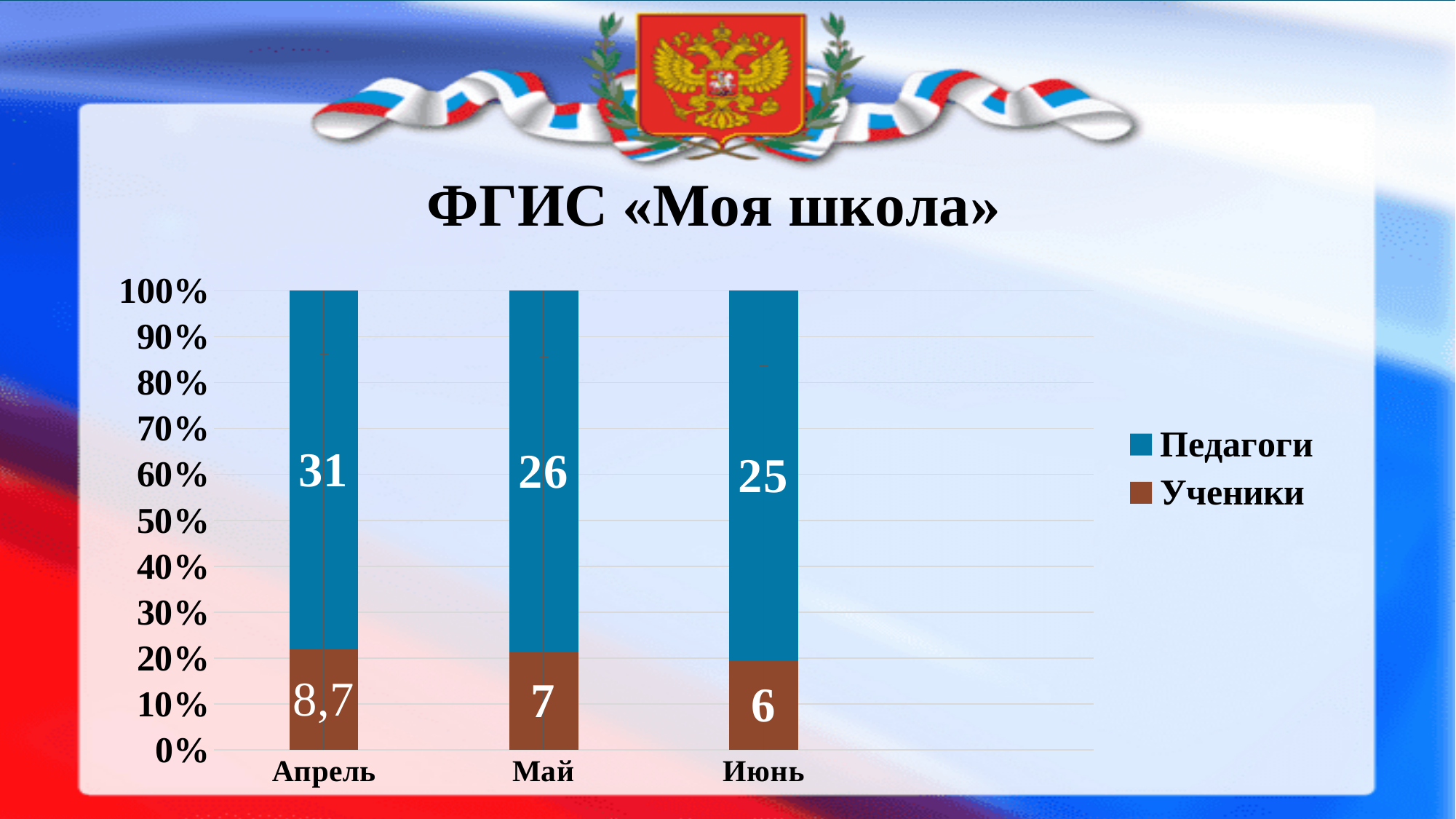
In which month is the Педагоги value highest? Апрель How many series does the legend list? 2 What is the value for Ученики in Апрель? 8,7 Which is larger, the Педагоги value for Май or for Июнь? Май What is the value for Педагоги in Апрель? 31 In which month is the Ученики value lowest? Июнь Do the Педагоги values rise or fall from Апрель to Июнь? Fall What kind of chart is shown on the slide? Stacked bar chart What is the value for Ученики in Май? 7 What is the value for Педагоги in Июнь? 25 How many months are shown on the x axis? 3 What is the difference between the Педагоги values for Апрель and Июнь? 6